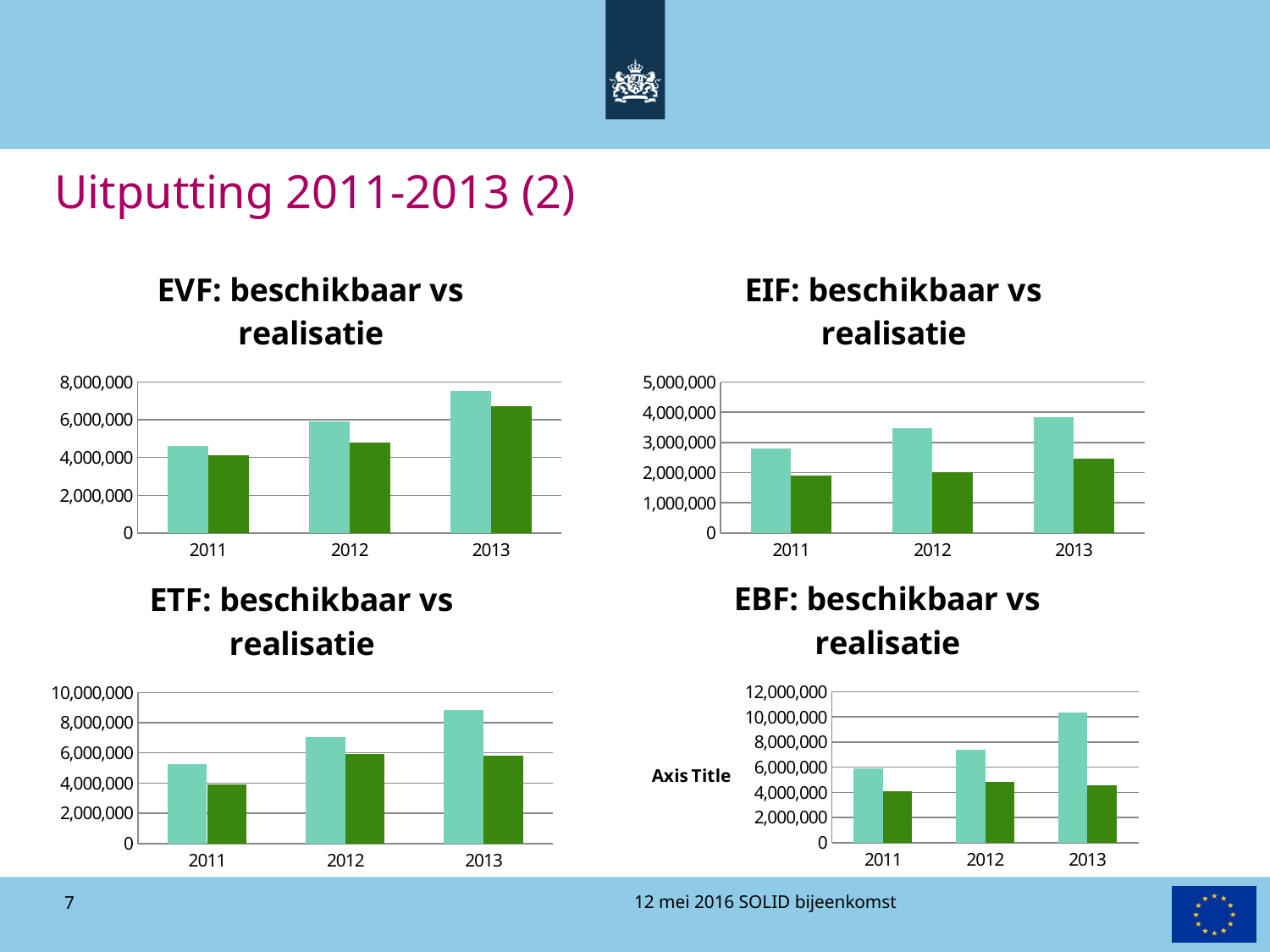
What is the highest value shown on the vertical axis of the 'EBF: beschikbaar vs realisatie' chart? 12,000,000 How many years are shown on the x axis of the 'EIF: beschikbaar vs realisatie' chart? 3 In the 'EBF: beschikbaar vs realisatie' chart, is the light green bar for 2013 greater or less than 8,000,000? greater In the 'EIF: beschikbaar vs realisatie' chart, is the light green bar for 2011 greater or less than 3,000,000? less In the 'EBF: beschikbaar vs realisatie' chart, which year has the tallest light green bar? 2013 In the 'ETF: beschikbaar vs realisatie' chart, do the light green bars rise or fall from 2011 to 2013? rise In the 'ETF: beschikbaar vs realisatie' chart, is the light green bar for 2013 greater or less than 8,000,000? greater In the 'EBF: beschikbaar vs realisatie' chart, which bar is taller for 2012, the light green or the dark green? light green In the 'EVF: beschikbaar vs realisatie' chart, which year has the shortest dark green bar? 2011 What kind of chart is the 'EVF: beschikbaar vs realisatie' chart? bar chart In the 'EIF: beschikbaar vs realisatie' chart, which bar is taller for 2013, the light green or the dark green? light green